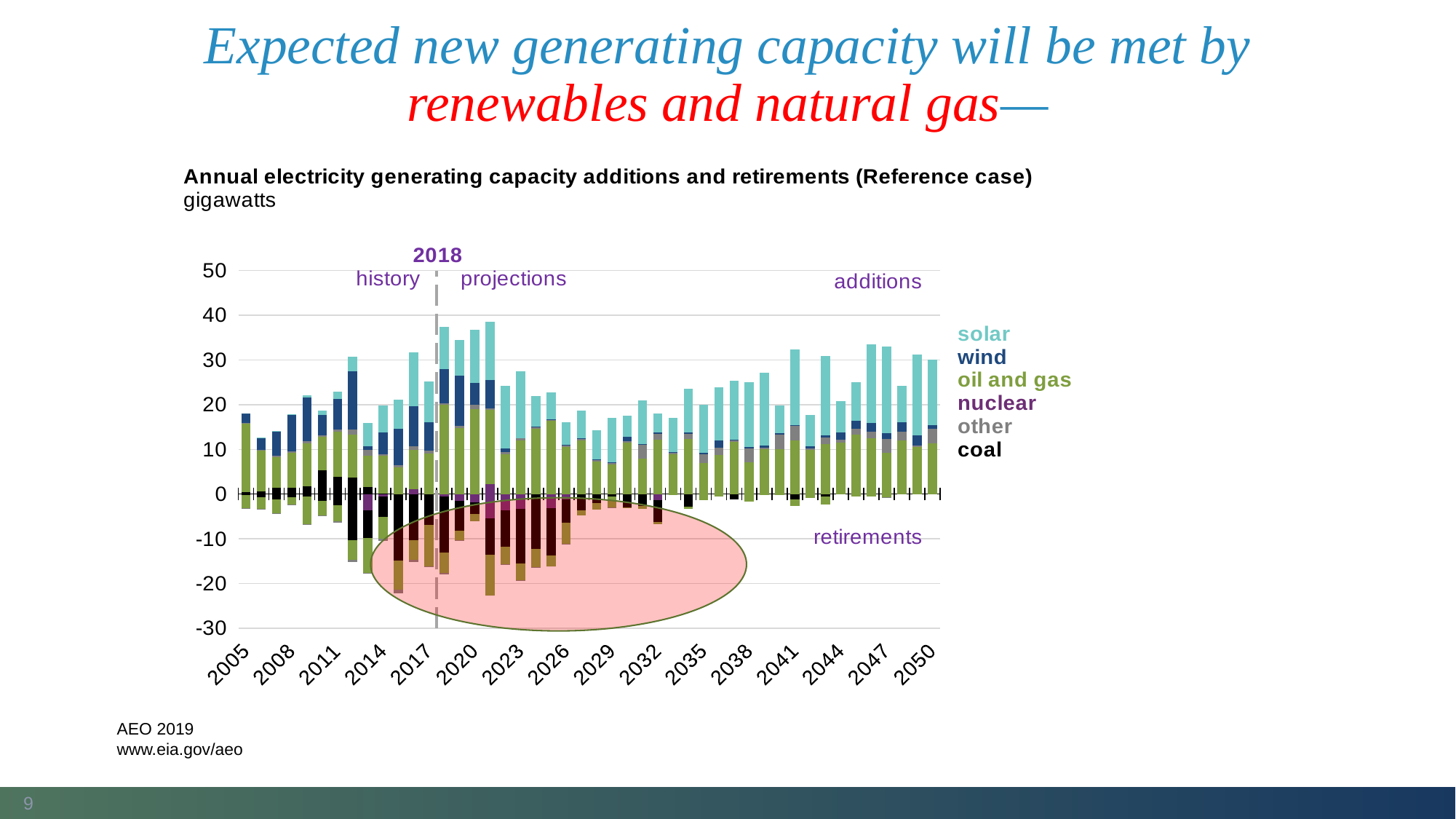
Is the total additions value for 2020 greater or less than 30? greater What is the title of the chart? Annual electricity generating capacity additions and retirements (Reference case) How many year labels are shown on the x axis? 16 What kind of chart is shown on the slide? stacked bar chart Is the total additions value for 2047 greater or less than 30? greater What unit is the y axis measured in? gigawatts Is the total additions value for 2005 greater or less than 20? less How many series does the legend list? 6 Which year's additions bar is taller, 2020 or 2029? 2020